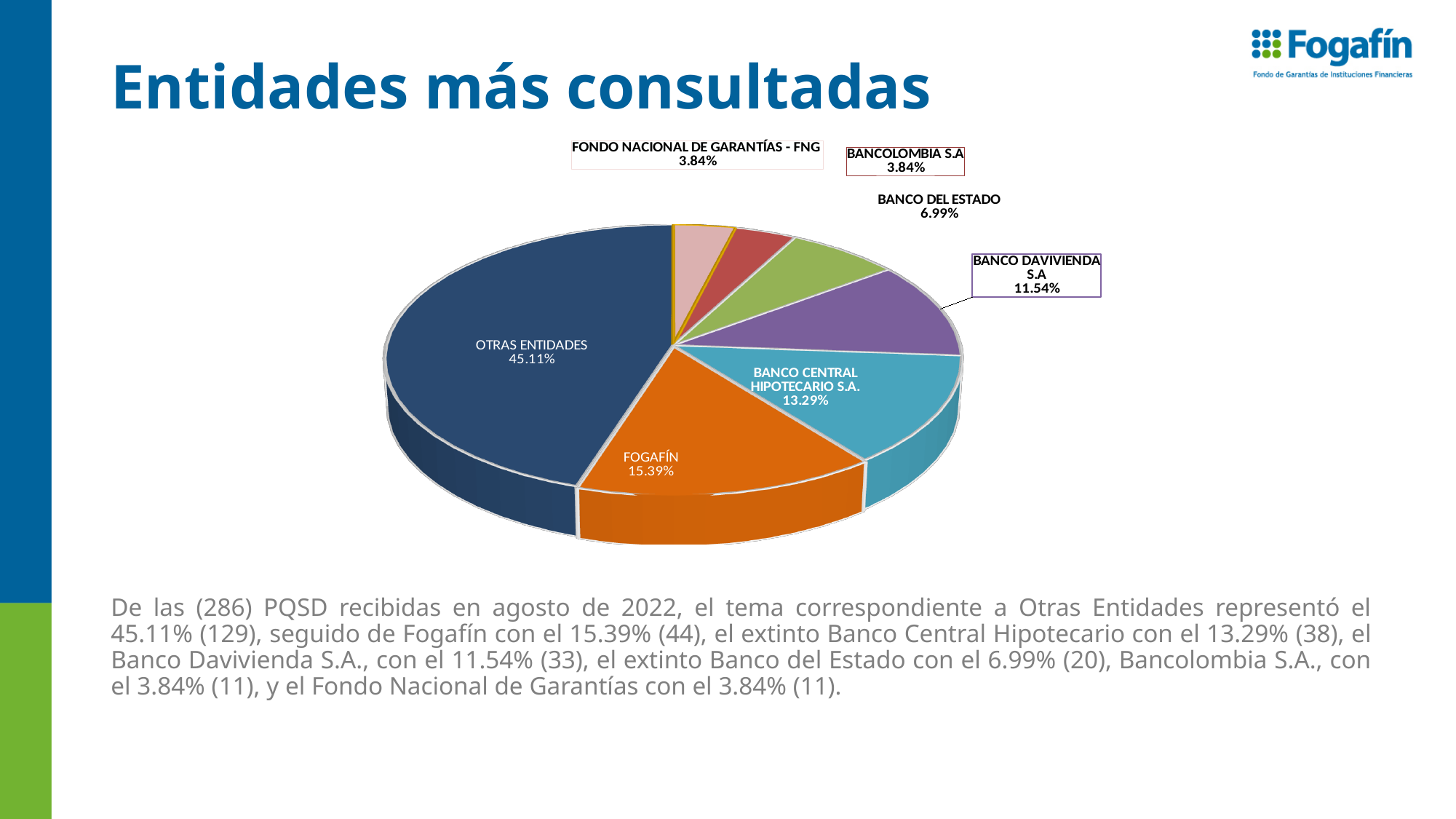
How many slices does the pie chart have? 7 What is the value shown for FOGAFÍN? 15.39% Which is larger, the share for BANCO DAVIVIENDA S.A or the share for BANCO DEL ESTADO? BANCO DAVIVIENDA S.A What is the value shown for BANCO DAVIVIENDA S.A? 11.54% What kind of chart is shown on the slide? Pie chart What is the difference between the shares of OTRAS ENTIDADES and FOGAFÍN? 29.72% What is the value shown for BANCO DEL ESTADO? 6.99% What share of the pie does OTRAS ENTIDADES represent? 45.11% What is the value shown for BANCO CENTRAL HIPOTECARIO S.A.? 13.29% What is the difference between the shares of FOGAFÍN and BANCO CENTRAL HIPOTECARIO S.A.? 2.10% What is the title of the slide containing the chart? Entidades más consultadas Which category has the largest slice of the pie? OTRAS ENTIDADES